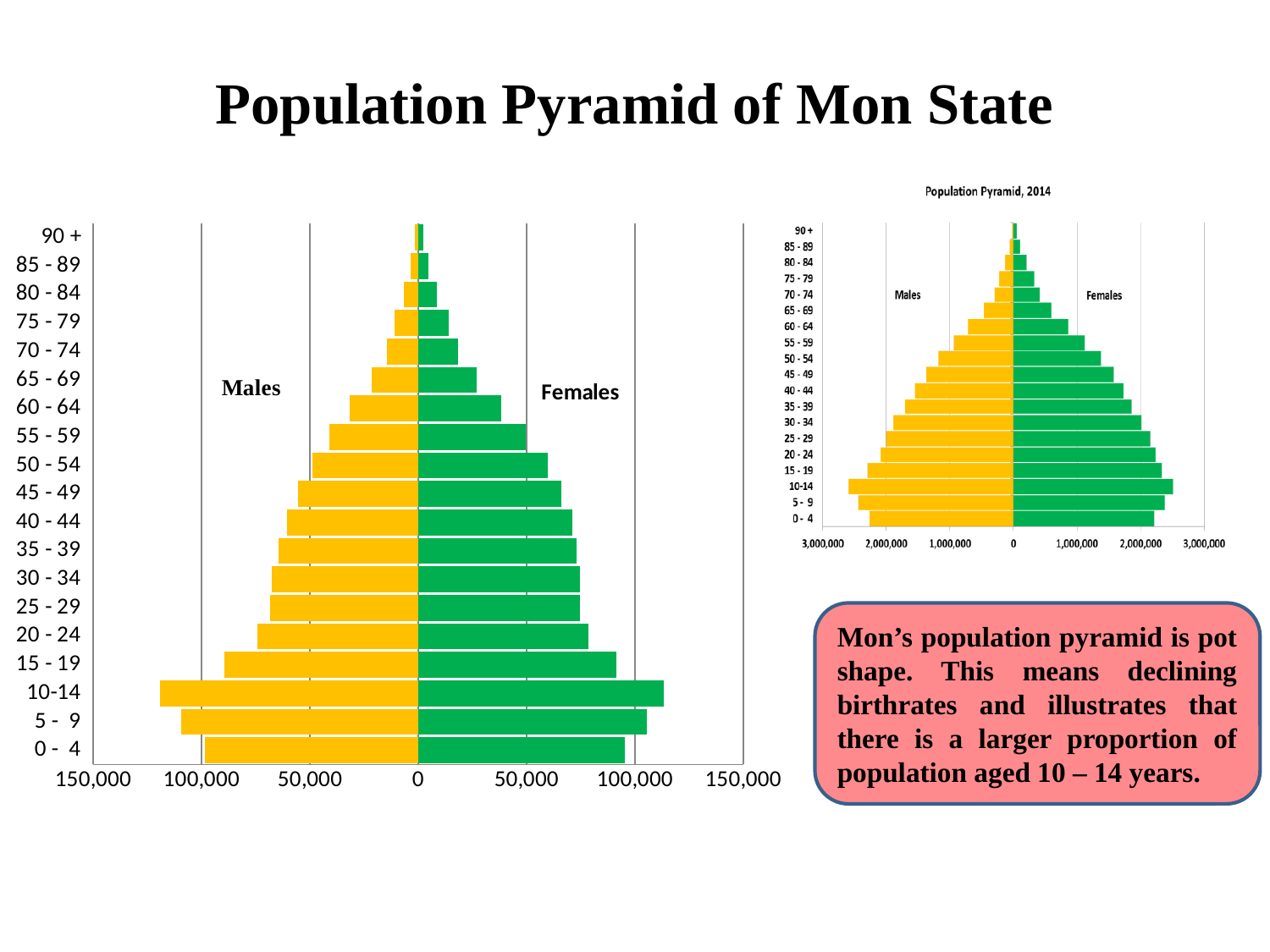
On the left Population Pyramid of Mon State, how many age groups are shown? 19 On the left Population Pyramid of Mon State, is the female value for the 20 - 24 age group greater or less than 50,000? greater On the left Population Pyramid of Mon State, which is larger: the female population aged 15 - 19 or the female population aged 25 - 29? 15 - 19 On the left Population Pyramid of Mon State, is the male value for the 60 - 64 age group greater or less than 50,000? less On the left Population Pyramid of Mon State, which is larger: the male population aged 10-14 or the male population aged 0 - 4? 10-14 What is the title of the small chart on the right of the slide? Population Pyramid, 2014 On the left Population Pyramid of Mon State, which age group has the smallest female population? 90 + On the small chart on the right, is the male value for the 10-14 age group greater or less than 2,000,000? greater On the left Population Pyramid of Mon State, what colour are the bars for Females? green On the left Population Pyramid of Mon State, which age group has the largest male population? 10-14 What kind of chart is the large Population Pyramid of Mon State on the left? bar chart